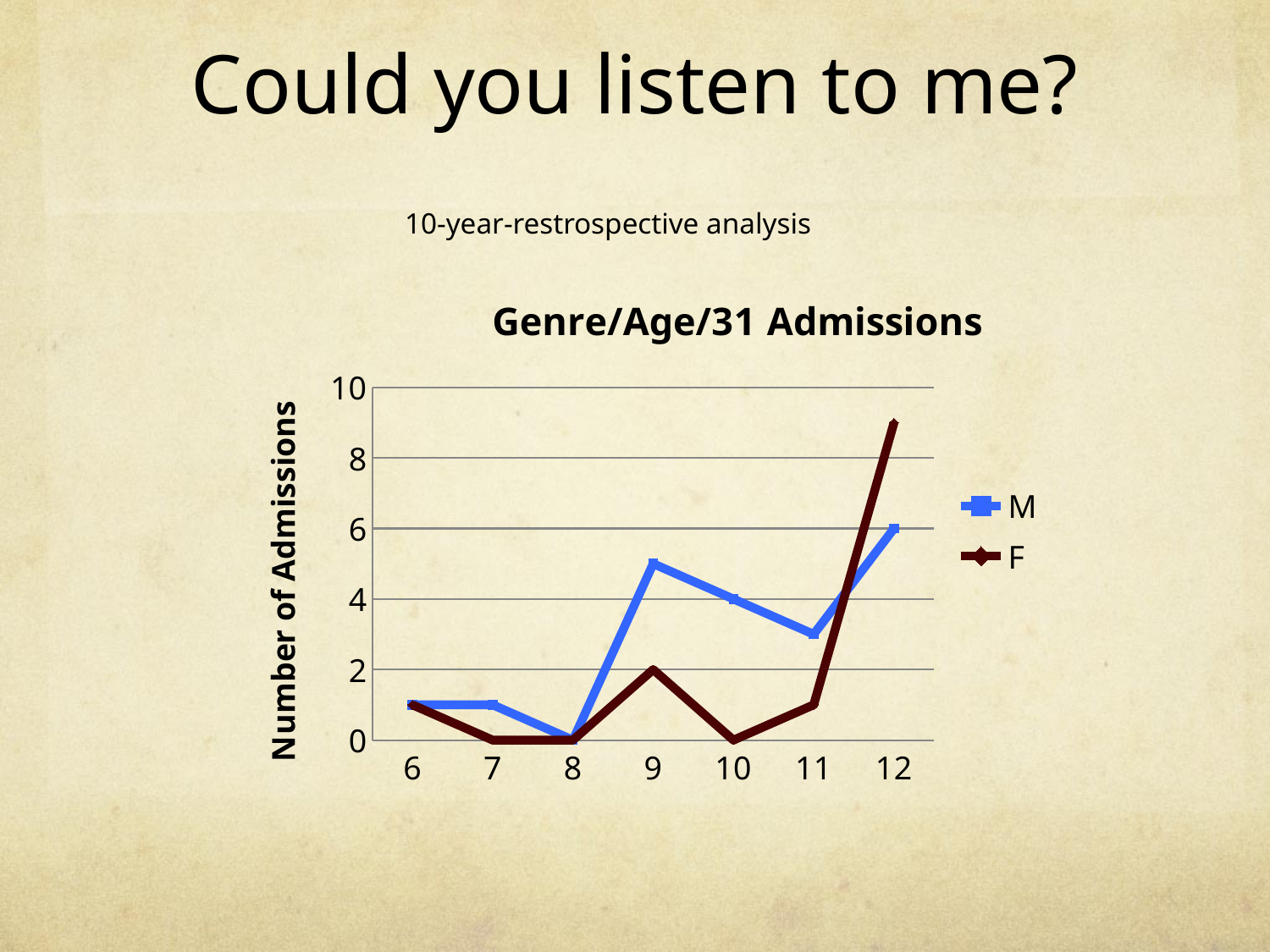
What is the value for series F at age 9? 2 Is the value for series F at age 12 greater or less than 8? greater At which age does series F reach its highest value? 12 What is the title of the chart? Genre/Age/31 Admissions How many age categories are plotted along the x axis? 7 At age 9, which series has the larger value, M or F? M What is the label on the vertical axis? Number of Admissions What is the value for series F at age 10? 0 How many series does the legend list? 2 What kind of chart is shown on the slide? line chart What is the value for series M at age 10? 4 What is the value for series M at age 12? 6